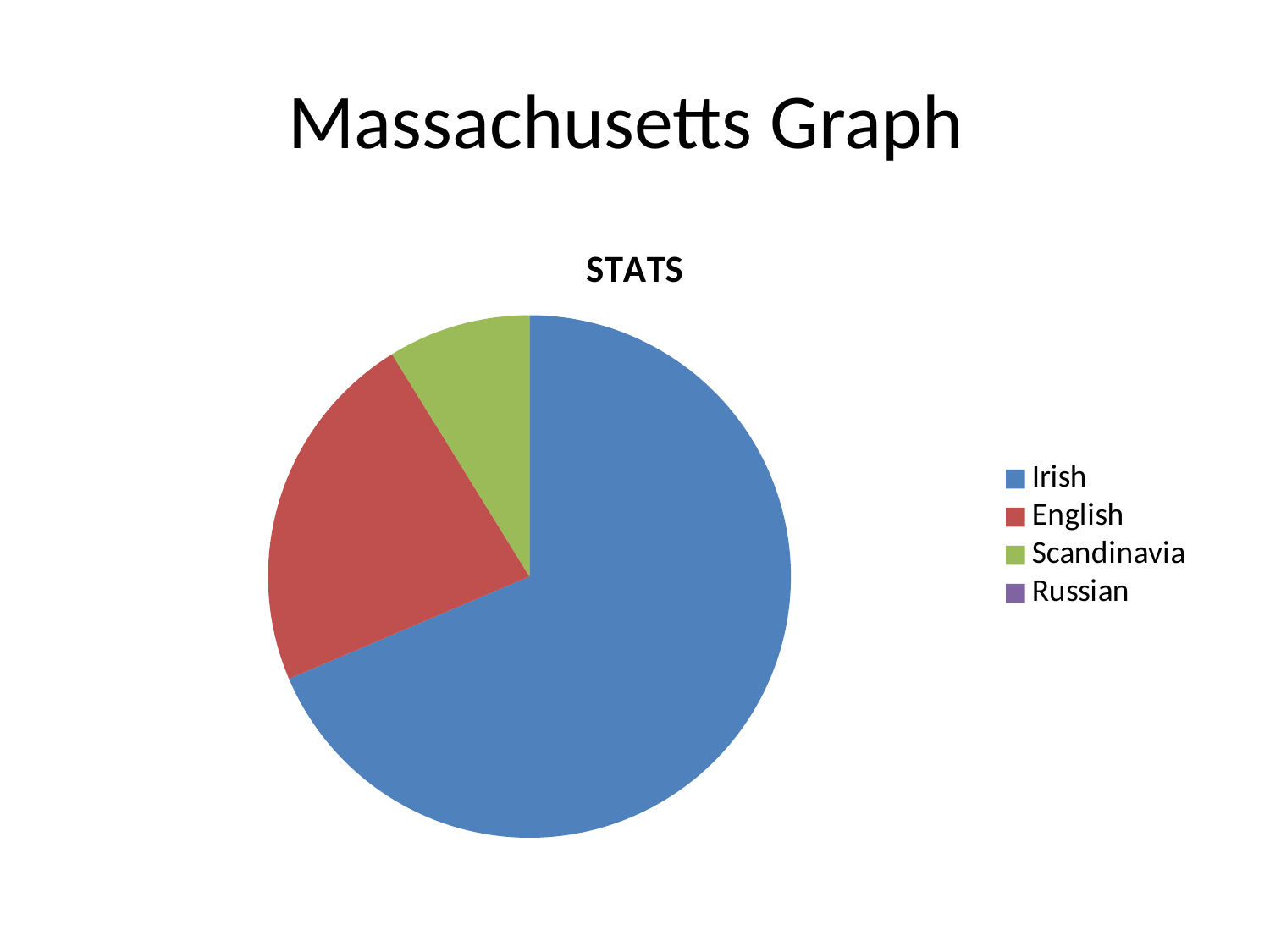
What is the title of the chart? STATS Which slice is larger, English or Scandinavia? English What colour is the Irish slice of the pie? blue Which slice is larger, Irish or English? Irish How many categories does the legend of the pie chart list? 4 Which category has the largest slice of the pie? Irish What kind of chart is shown on the slide? pie chart Which slice is larger, Irish or Scandinavia? Irish